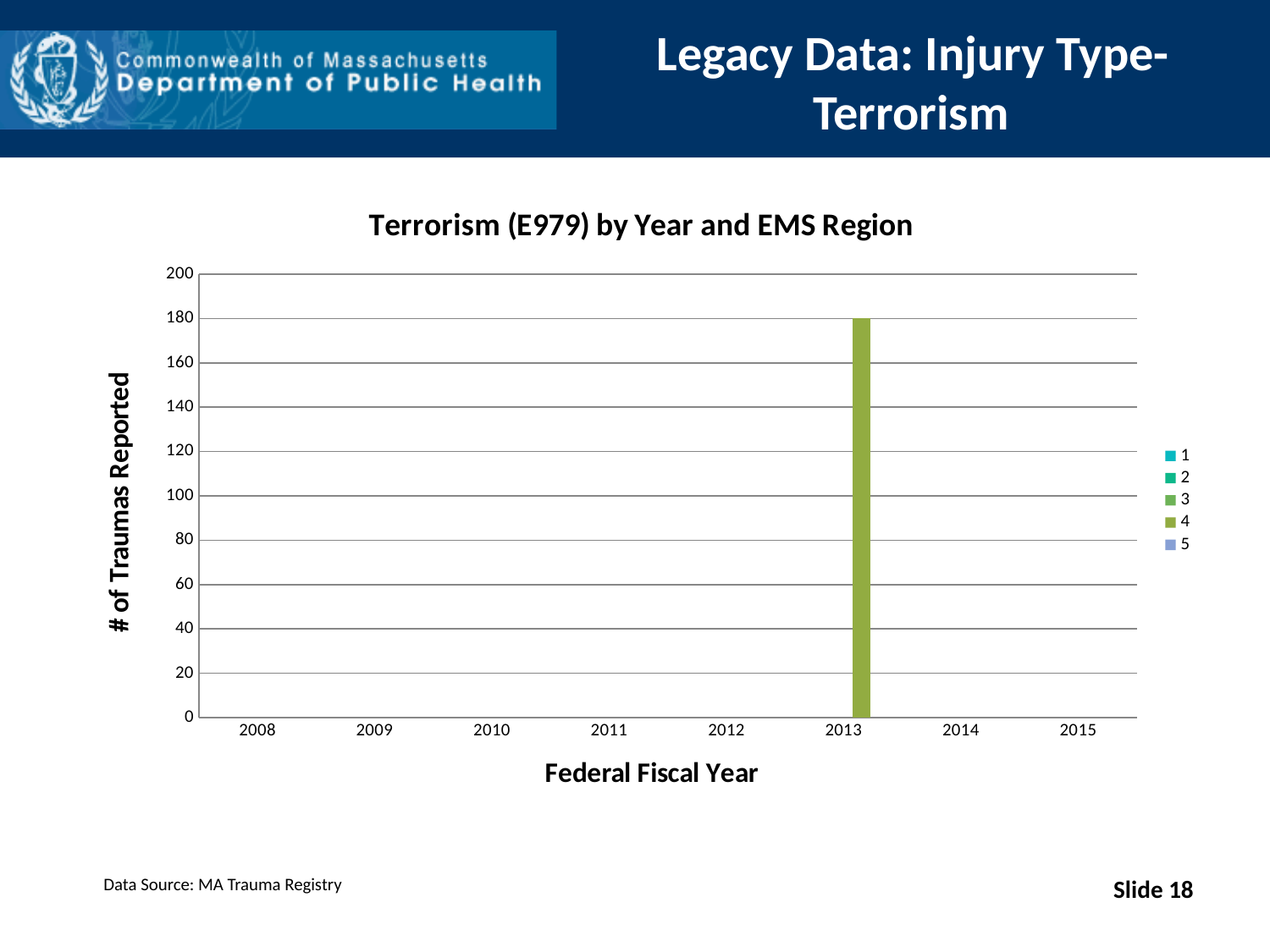
What is the title of the chart? Terrorism (E979) by Year and EMS Region How many years are shown on the x axis? 8 What is the first year shown on the x axis? 2008 Which year has the highest number of traumas reported? 2013 Is the value for 2013 greater or less than 160? greater What is the label of the x axis? Federal Fiscal Year Is the value for 2013 greater or less than 200? less Which year has the larger value, 2012 or 2013? 2013 What is the last year shown on the x axis? 2015 What kind of chart is shown on the slide? bar chart Which is the only year with a visible bar in the chart? 2013 How many series does the legend list? 5